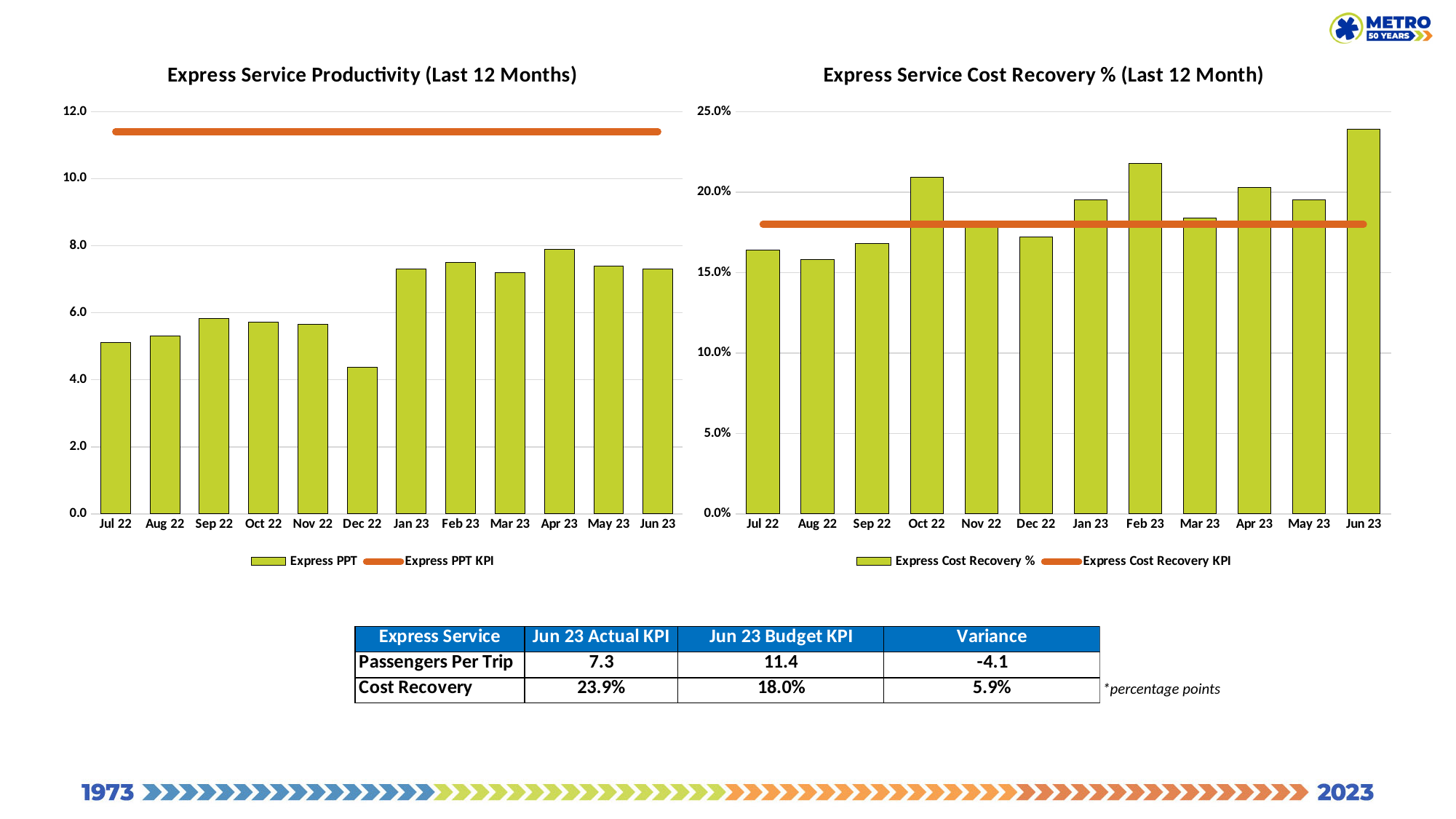
In the Express Service Cost Recovery % (Last 12 Month) chart, which month has the highest cost recovery value? Jun 23 In the Express Service Cost Recovery % (Last 12 Month) chart, what is the Express Cost Recovery % value for Jun 23? 23.9% In the Express Service Cost Recovery % (Last 12 Month) chart, is the value for Dec 22 greater or less than 20.0%? less In the Express Service Cost Recovery % (Last 12 Month) chart, do the values generally rise or fall from Jul 22 to Jun 23? rise In the Express Service Productivity (Last 12 Months) chart, how many months are shown on the x axis? 12 How many series does the legend of the Express Service Productivity (Last 12 Months) chart list? 2 In the Express Service Cost Recovery % (Last 12 Month) chart, which is larger, the value for Oct 22 or the value for Nov 22? Oct 22 In the Express Service Productivity (Last 12 Months) chart, is the Express PPT value for Dec 22 greater or less than 6.0? less What kind of chart is the Express Service Productivity (Last 12 Months) chart? bar chart In the Express Service Productivity (Last 12 Months) chart, what is the Express PPT value for Jun 23? 7.3 In the Express Service Productivity (Last 12 Months) chart, which month has the highest Express PPT value? Apr 23 In the Express Service Productivity (Last 12 Months) chart, which month has the lowest Express PPT value? Dec 22